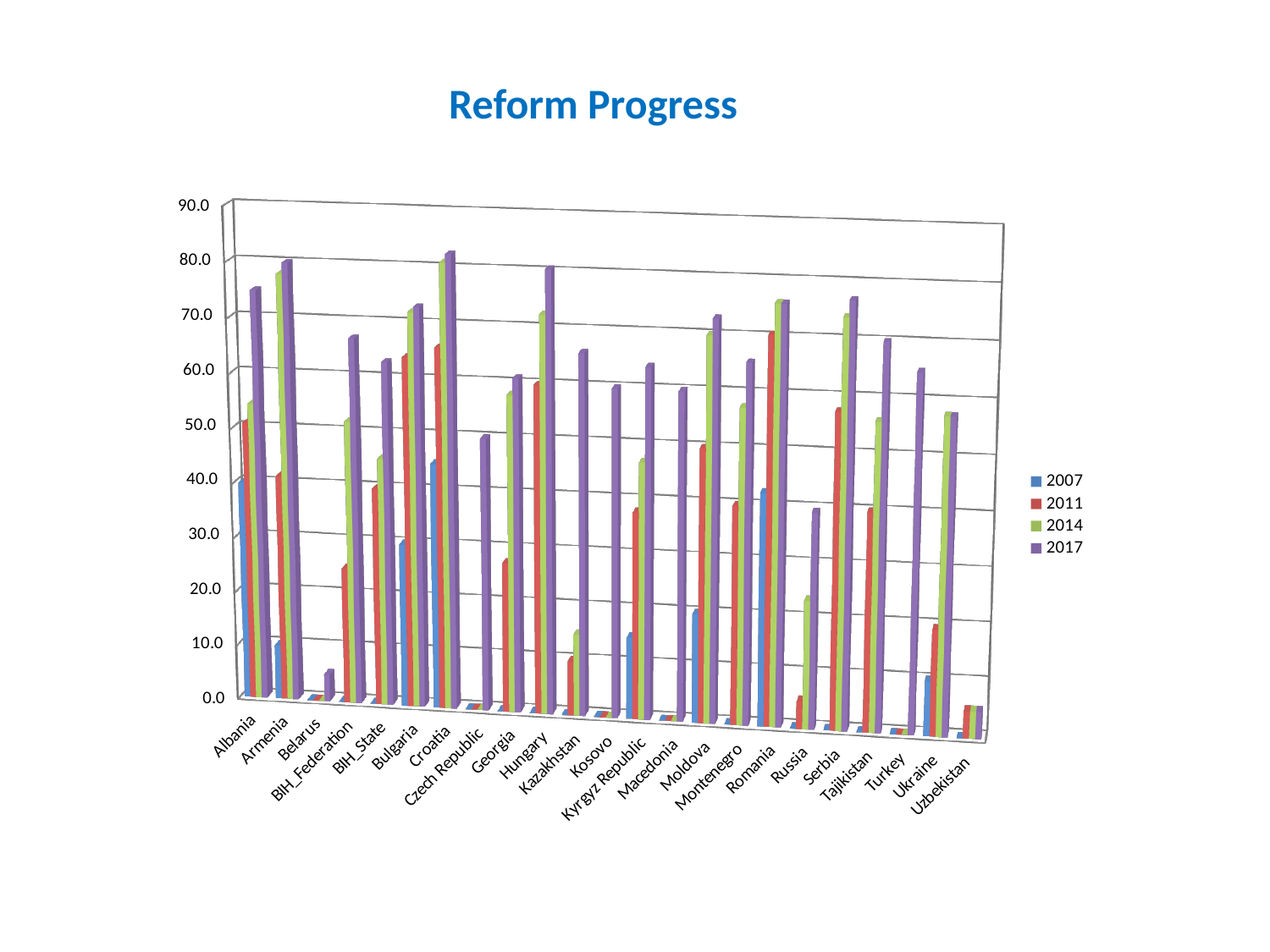
Which has the larger 2017 value, Croatia or Russia? Croatia How many countries (categories) are shown on the x axis? 23 Is the 2017 value for Belarus greater or less than 10? less Is the 2014 value for Ukraine greater or less than 40? greater What kind of chart is shown on the slide? bar chart Is the 2014 value for Turkey greater or less than 10? less What is the title of the chart? Reform Progress Which series is shown in purple in the legend? 2017 How many series does the legend list? 4 Which has the larger 2017 value, Belarus or Albania? Albania